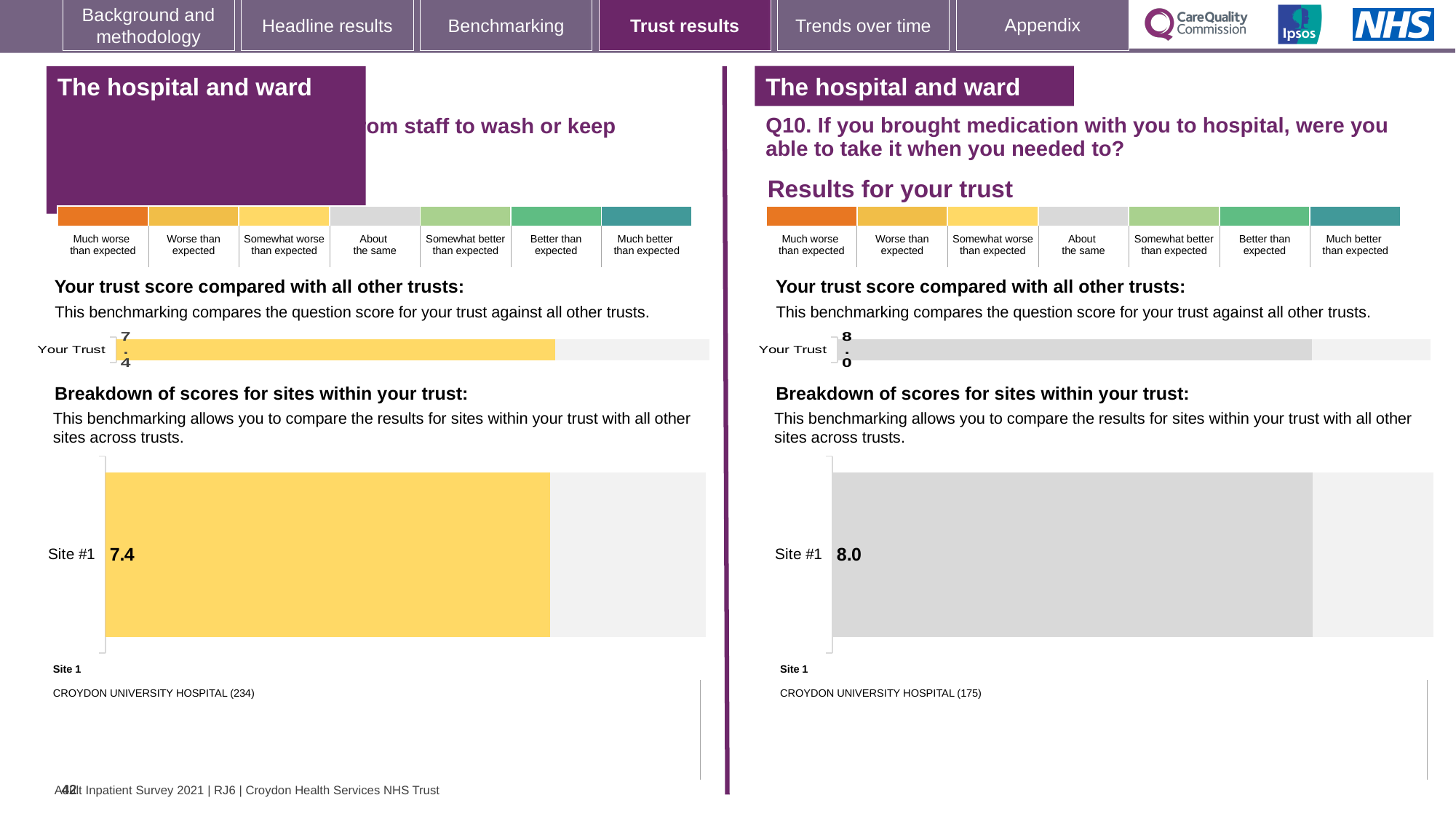
On the right-hand chart for Q10 (medication), what is the score shown for Site #1? 8.0 What type of chart is used to show the Your Trust score on each half of the slide? Bar chart According to the colour key, which benchmark category does the grey colour of the Your Trust bar on the right-hand Q10 chart represent? About the same What is the difference between the Site #1 score on the right-hand Q10 chart and the Site #1 score on the left-hand chart? 0.6 On the left-hand chart (the question about staff helping to wash or keep clean), what is the score shown for Your Trust? 7.4 How many sites are shown in the site breakdown chart on the right-hand Q10 half of the slide? 1 On the left-hand chart, what is the score shown for Site #1? 7.4 Is the Your Trust score on the left-hand chart greater or less than 8.0? less Which site is listed as Site 1 on the right-hand Q10 half of the slide? CROYDON UNIVERSITY HOSPITAL (175) Which is larger: the Your Trust score on the left-hand chart or the Your Trust score on the right-hand Q10 chart? The right-hand Q10 chart On the right-hand chart for Q10 (medication), what is the score shown for Your Trust? 8.0